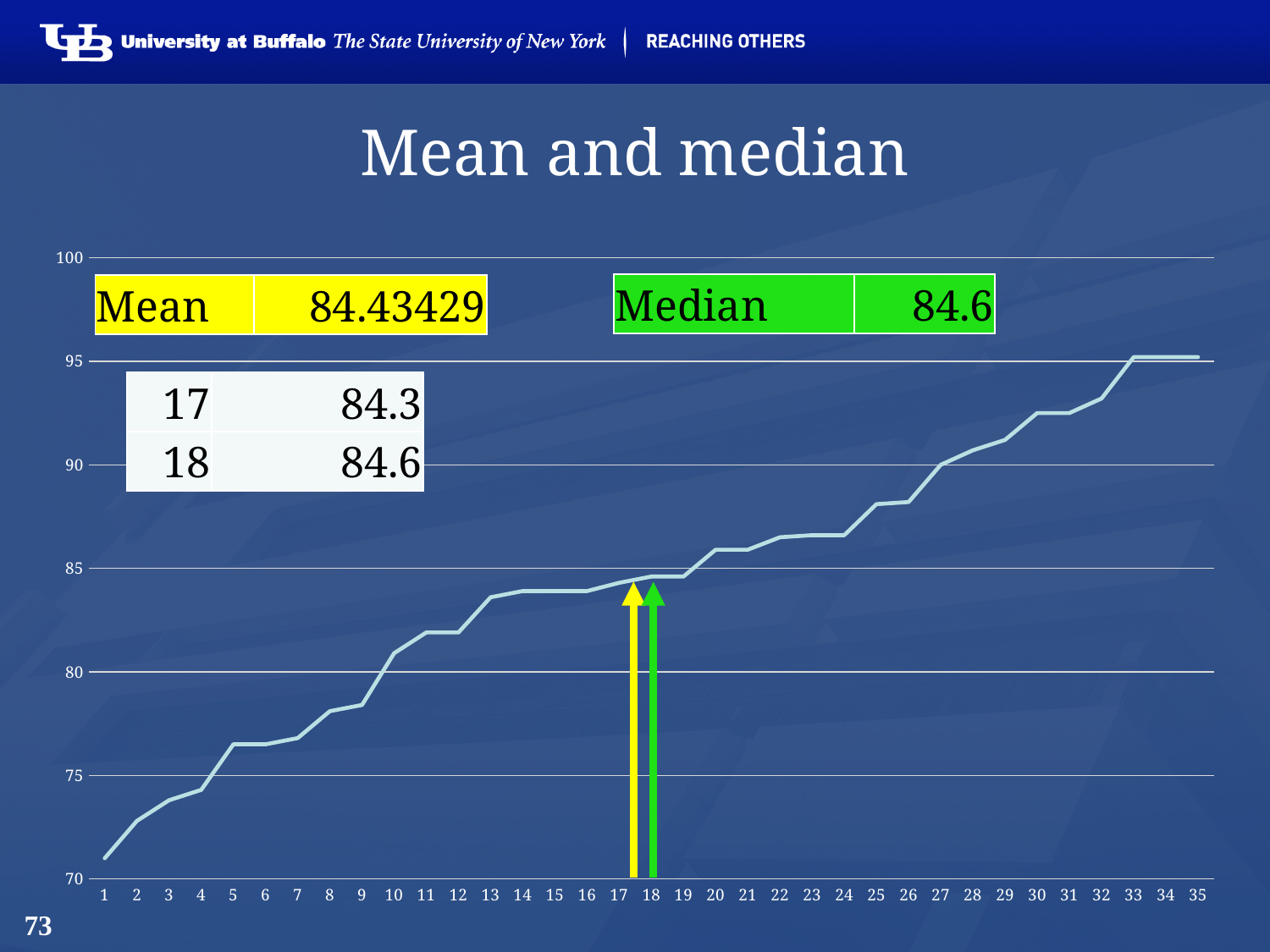
What is the mean value shown on the slide? 84.43429 Which position has the lowest plotted value? 1 What kind of chart is shown on the slide? line chart According to the table on the slide, what is the value at position 18? 84.6 Is the value at position 30 greater or less than 90? greater What colour is the arrow pointing at position 18? green How many points are plotted along the x axis of the chart? 35 Is the value at position 1 greater or less than 75? less What is the median value shown on the slide? 84.6 What is the difference between the values at positions 18 and 17? 0.3 Do the plotted values rise or fall as the x axis goes from 1 to 35? rise According to the table on the slide, what is the value at position 17? 84.3